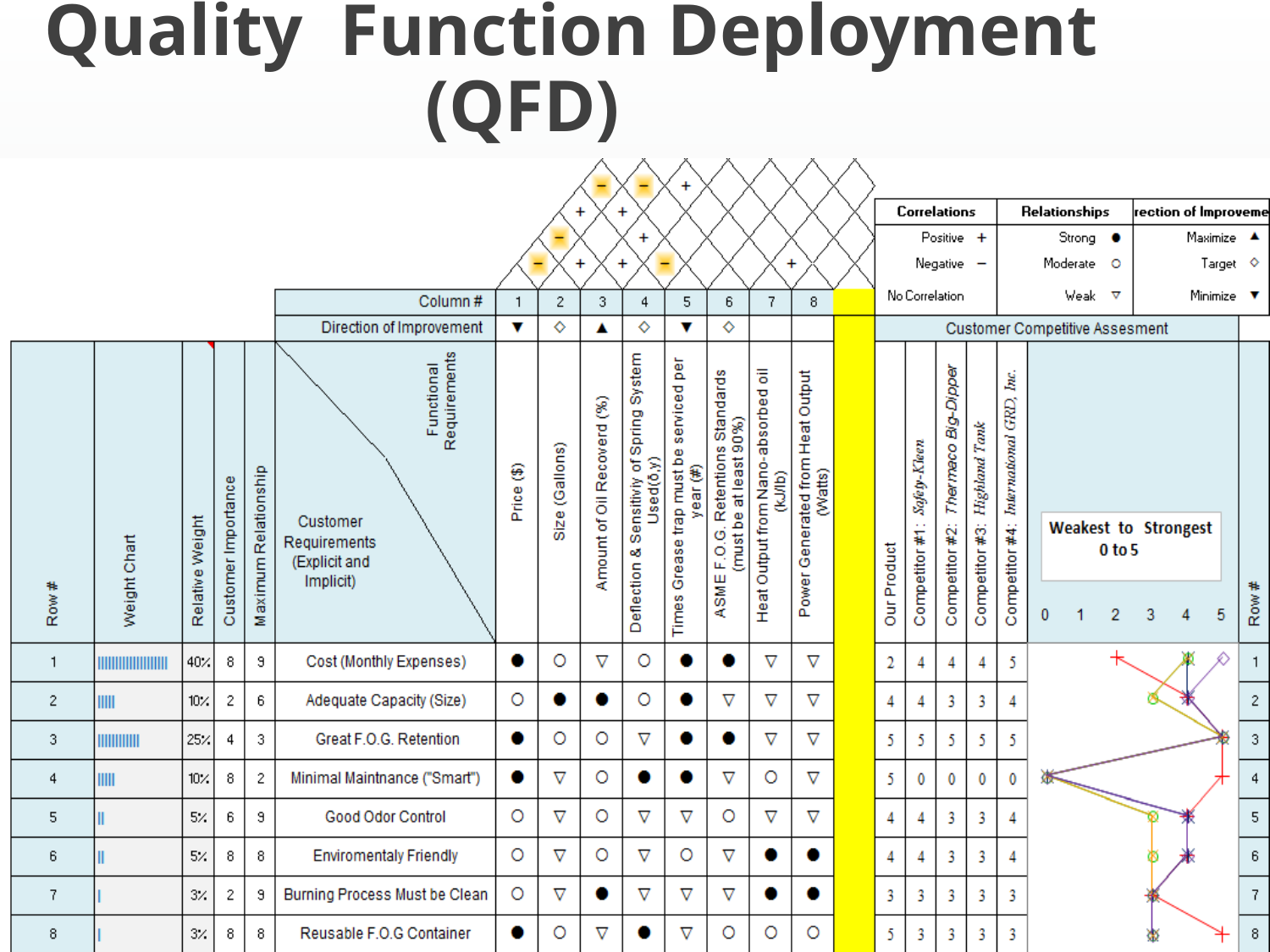
How many products (Our Product plus competitors) are compared in the Customer Competitive Assessment? 5 In the Customer Competitive Assessment chart, what is the scale range shown for the scores? 0 to 5 In the Customer Competitive Assessment chart, what is the difference between Our Product and Competitor #1 (Safety-Kleen) for Minimal Maintnance ("Smart")? 5 How many customer requirement rows are listed in the QFD matrix? 8 In the Customer Competitive Assessment chart, what score does Our Product receive for Cost (Monthly Expenses)? 2 In the Customer Competitive Assessment chart, which scores higher on Reusable F.O.G Container: Our Product or Competitor #2 (Thermaco Big-Dipper)? Our Product What is the relative weight for Great F.O.G. Retention? 25% In the Customer Competitive Assessment chart, what score does Competitor #3 (Highland Tank) receive for Good Odor Control? 3 What is the relative weight for Cost (Monthly Expenses)? 40% In the Customer Competitive Assessment chart, what score does Competitor #4 (International GRD, Inc.) receive for Cost (Monthly Expenses)? 5 Which customer requirement has the highest relative weight in the Weight Chart? Cost (Monthly Expenses) What kind of chart is used in the Customer Competitive Assessment section on the right? line chart